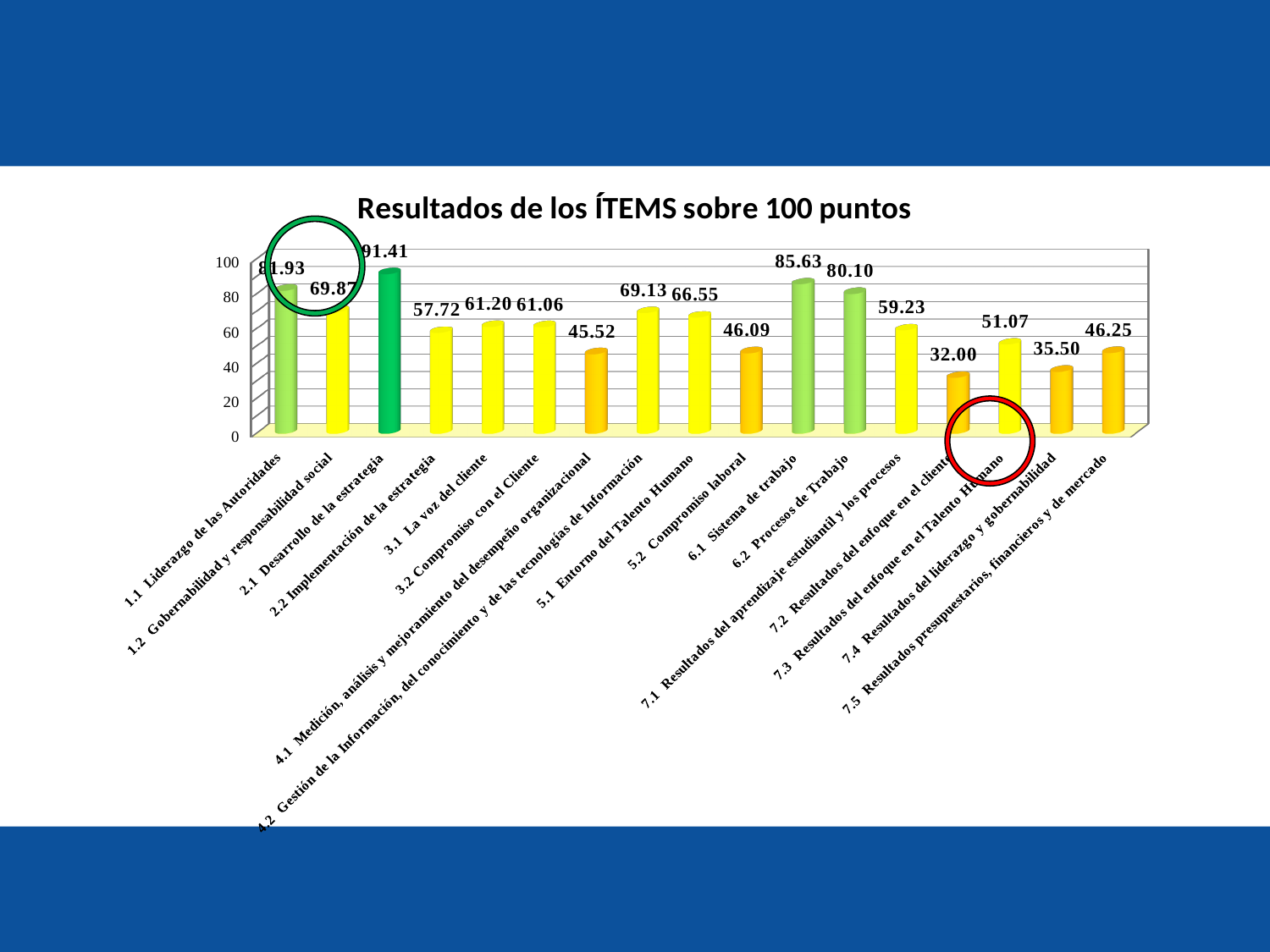
What type of chart is shown on the slide? bar chart What is the value for 2.1 Desarrollo de la estrategia? 91.41 What is the value for 4.1 Medición, análisis y mejoramiento del desempeño organizacional? 45.52 What is the value for 6.1 Sistema de trabajo? 85.63 What is the title of the chart? Resultados de los ÍTEMS sobre 100 puntos What is the difference between the values for 6.1 Sistema de trabajo and 6.2 Procesos de Trabajo? 5.53 Is the value for 7.4 Resultados del liderazgo y gobernabilidad greater or less than 40? less What is the value for 7.2 Resultados del enfoque en el cliente? 32.00 Which category has the highest value? 2.1 Desarrollo de la estrategia Which is larger, the value for 5.1 Entorno del Talento Humano or the value for 5.2 Compromiso laboral? 5.1 Entorno del Talento Humano How many categories are shown on the x axis? 17 Which category has the lowest value? 7.2 Resultados del enfoque en el cliente